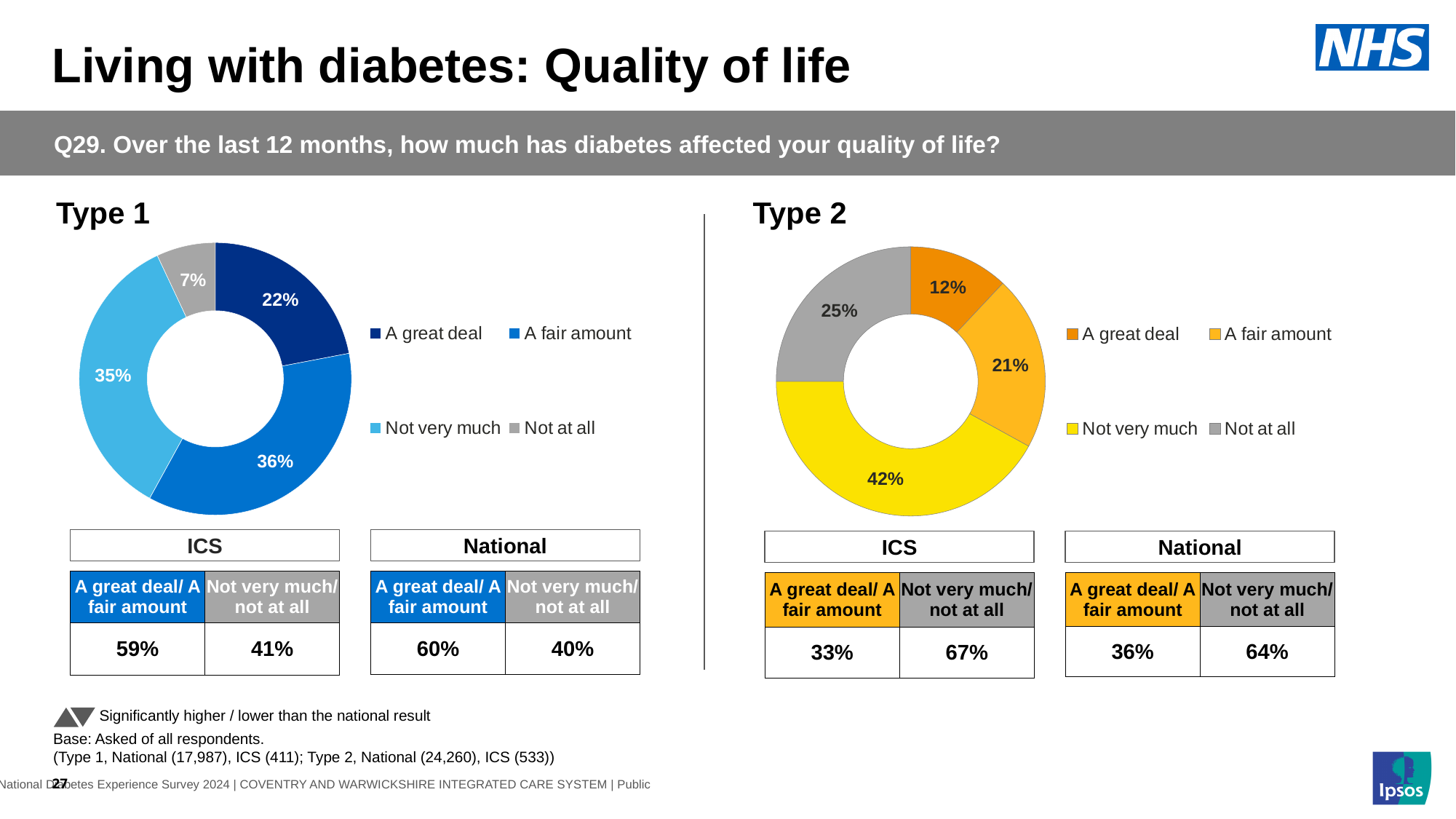
In the Type 1 chart, what percentage of respondents answered 'Not at all'? 7% In the Type 2 chart, what percentage of respondents answered 'Not very much'? 42% In the Type 2 chart, what is the difference in percentage points between 'Not very much' and 'Not at all'? 17 In the Type 2 chart, which response category has the largest share? Not very much How many response categories does the legend of the Type 1 chart list? 4 In the Type 2 chart, which response category has the smallest share? A great deal In the Type 1 chart, what is the difference in percentage points between 'A fair amount' and 'A great deal'? 14 In the Type 2 chart, what percentage of respondents answered 'A fair amount'? 21% In the Type 1 chart, what percentage of respondents said diabetes affected their quality of life 'A great deal'? 22% Which is larger in the Type 2 chart: the share for 'A great deal' or the share for 'Not at all'? Not at all In the Type 1 chart, which response category has the smallest share? Not at all What type of chart is used to show the Type 2 results? Donut (pie) chart